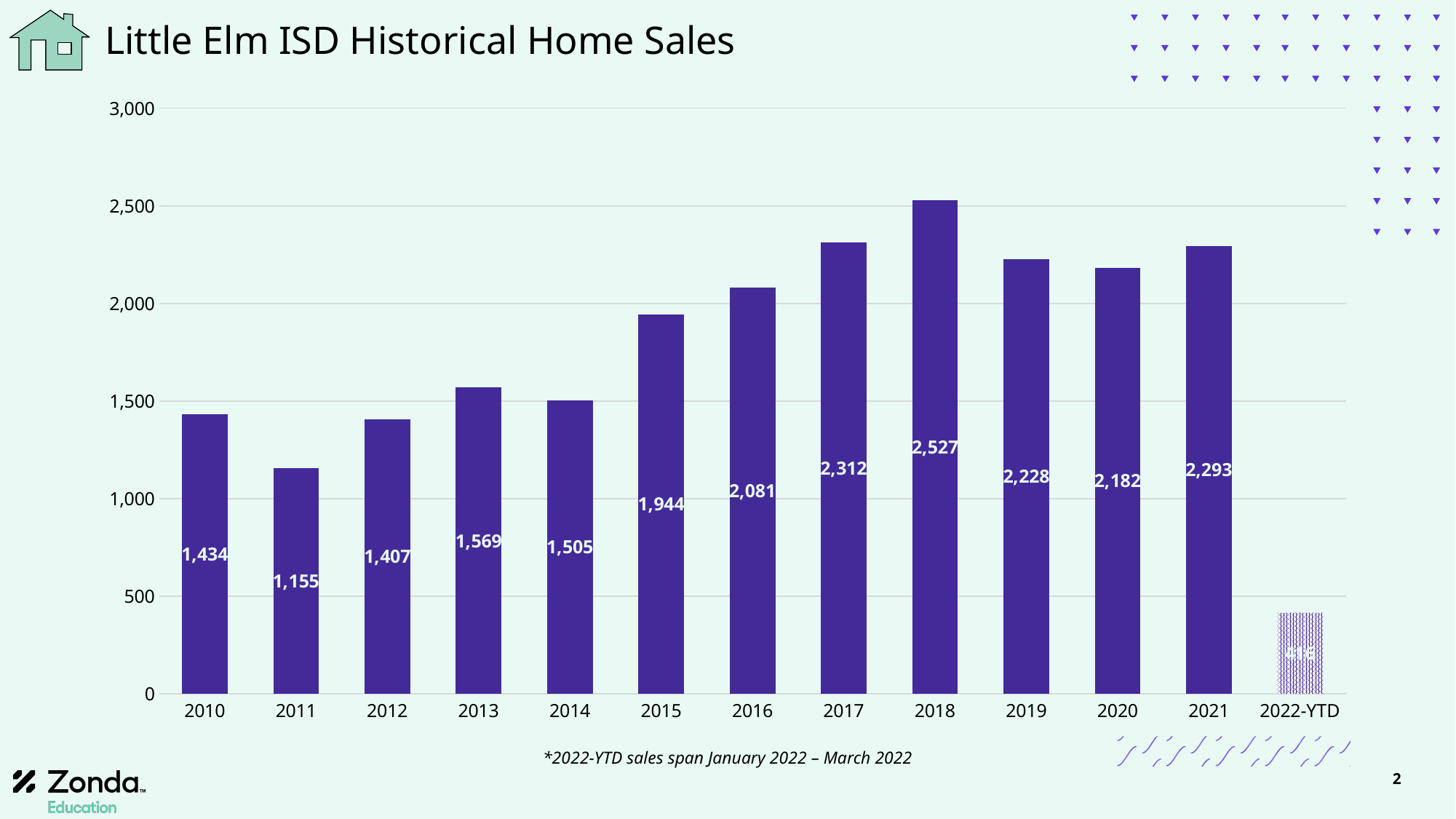
Which full year (excluding 2022-YTD) has the lowest home sales? 2011 What kind of chart is shown on the slide? bar chart Which full year has the highest home sales? 2018 What is the title of the chart? Little Elm ISD Historical Home Sales What is the value for 2018? 2,527 How many categories are shown on the x axis? 13 What is the difference between the values for 2013 and 2014? 64 What is the value for 2011? 1,155 What is the value for 2015? 1,944 Which is larger, the value for 2019 or the value for 2020? 2019 Is the value for 2022-YTD greater or less than 500? less What is the difference between the values for 2018 and 2021? 234